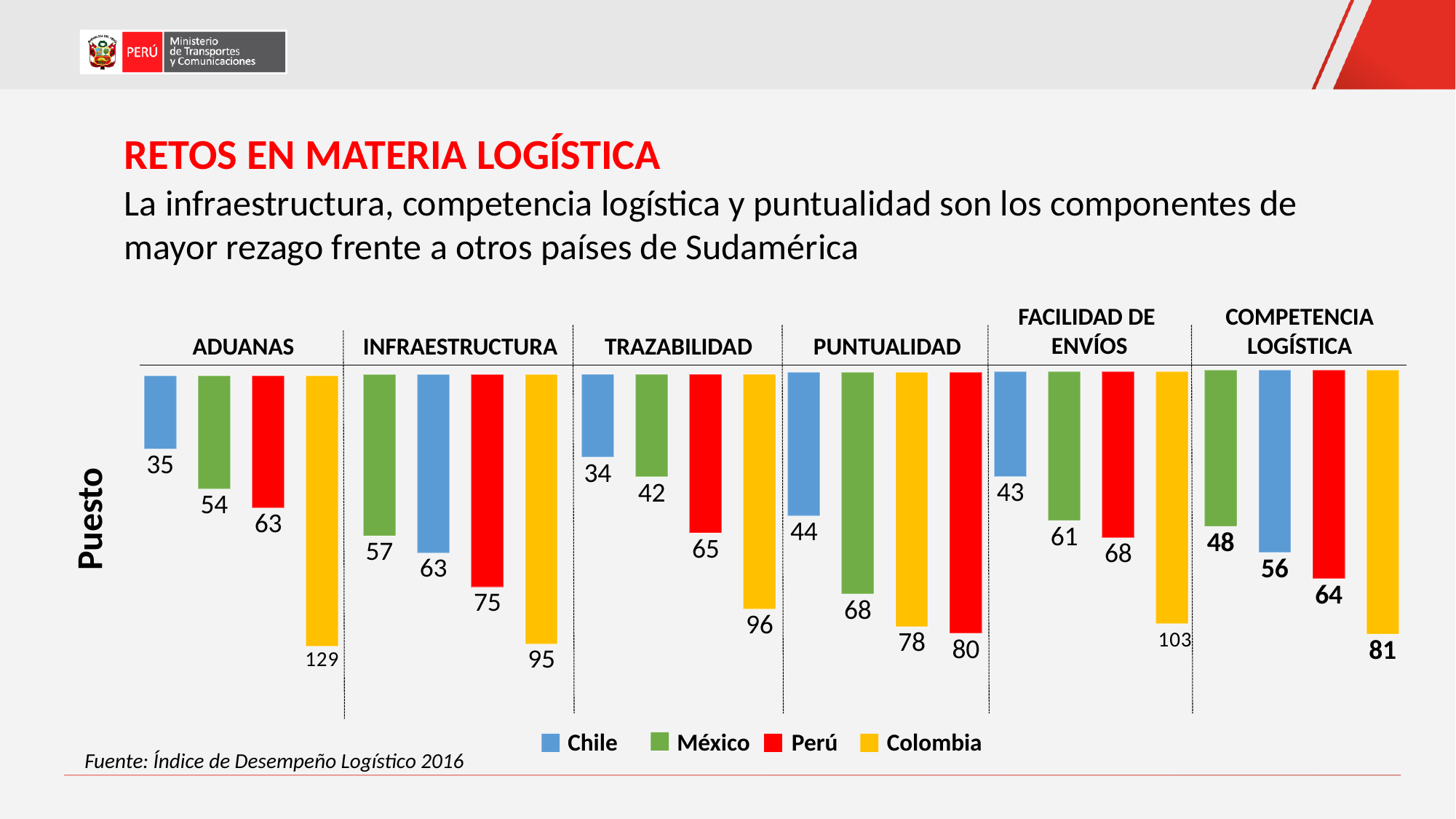
What is the value for Colombia in the FACILIDAD DE ENVÍOS category? 103 What kind of chart is shown on the slide? Bar chart What is the difference between Colombia's and Chile's values in the INFRAESTRUCTURA category? 32 What is the value for Perú in the ADUANAS category? 63 What is the value for México in the COMPETENCIA LOGÍSTICA category? 48 How many categories are shown on the x axis of the chart? 6 Which country has the lowest value in the PUNTUALIDAD category? Chile Which country has the highest value in the ADUANAS category? Colombia In the PUNTUALIDAD category, which is larger: the value for Perú or the value for Colombia? Perú How many series does the legend list? 4 What is the value for Chile in the TRAZABILIDAD category? 34 Which colour represents Perú in the chart? Red